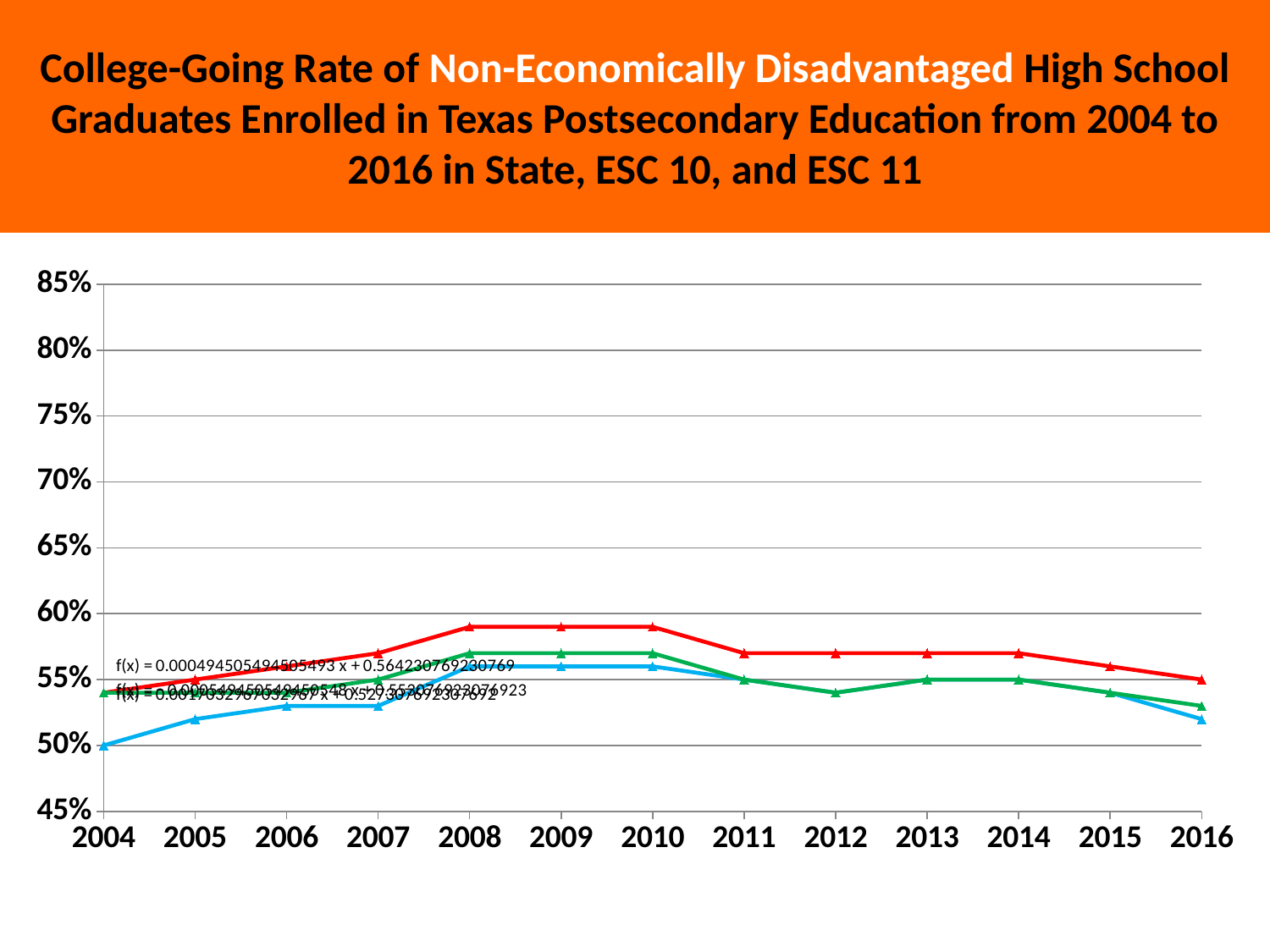
Is the value of the red line in 2016 greater or less than 60%? less How many years are shown along the x axis of the chart? 13 In which year is the blue line at its lowest value? 2004 Is the value of the blue line in 2005 greater or less than 55%? less Is the value of the green line in 2008 greater or less than 55%? greater In 2004, which line has the higher value, the red line or the blue line? red line In 2008, which line has the higher value, the red line or the green line? red line What kind of chart is shown on the slide? line chart How many lines are plotted on the chart? 3 Does the red line rise or fall from 2010 to 2016? fall